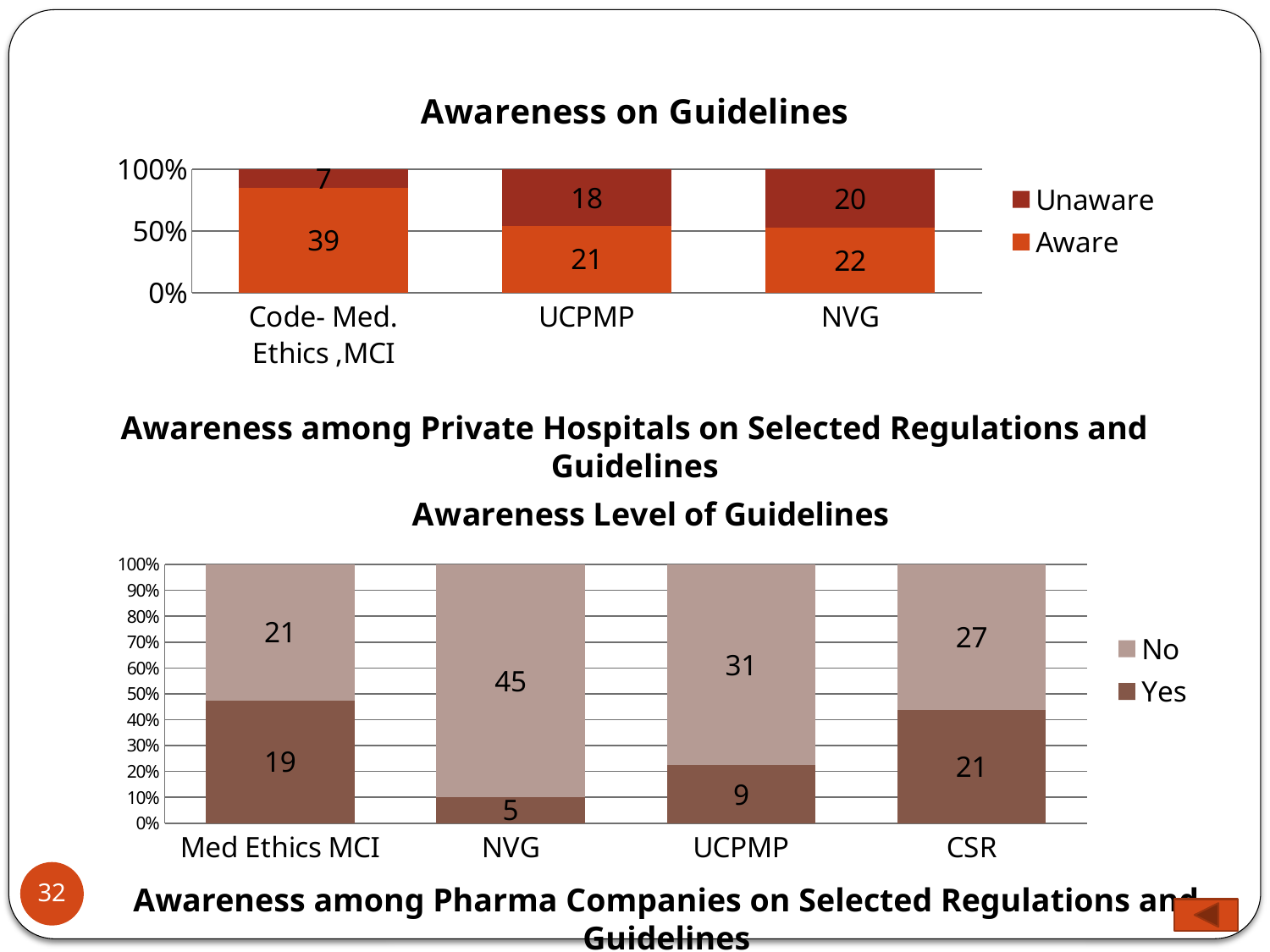
In the 'Awareness Level of Guidelines' chart, which category has the highest Yes value? CSR In the 'Awareness Level of Guidelines' chart, what is the total of the stacked bar for Med Ethics MCI? 40 In the 'Awareness on Guidelines' chart, what is the Aware value for Code- Med. Ethics ,MCI? 39 What kind of chart is the 'Awareness Level of Guidelines' chart? Stacked bar chart In the 'Awareness on Guidelines' chart, what is the total of the stacked bar for NVG? 42 In the 'Awareness Level of Guidelines' chart, what is the No value for NVG? 45 In the 'Awareness on Guidelines' chart, what is the difference between the Aware and Unaware values for UCPMP? 3 In the 'Awareness Level of Guidelines' chart, what is the Yes value for UCPMP? 9 In the 'Awareness on Guidelines' chart, what is the Unaware value for NVG? 20 In the 'Awareness on Guidelines' chart, which category has the lowest Unaware value? Code- Med. Ethics ,MCI How many series does the legend of the 'Awareness on Guidelines' chart list? 2 How many categories are shown on the x axis of the 'Awareness Level of Guidelines' chart? 4